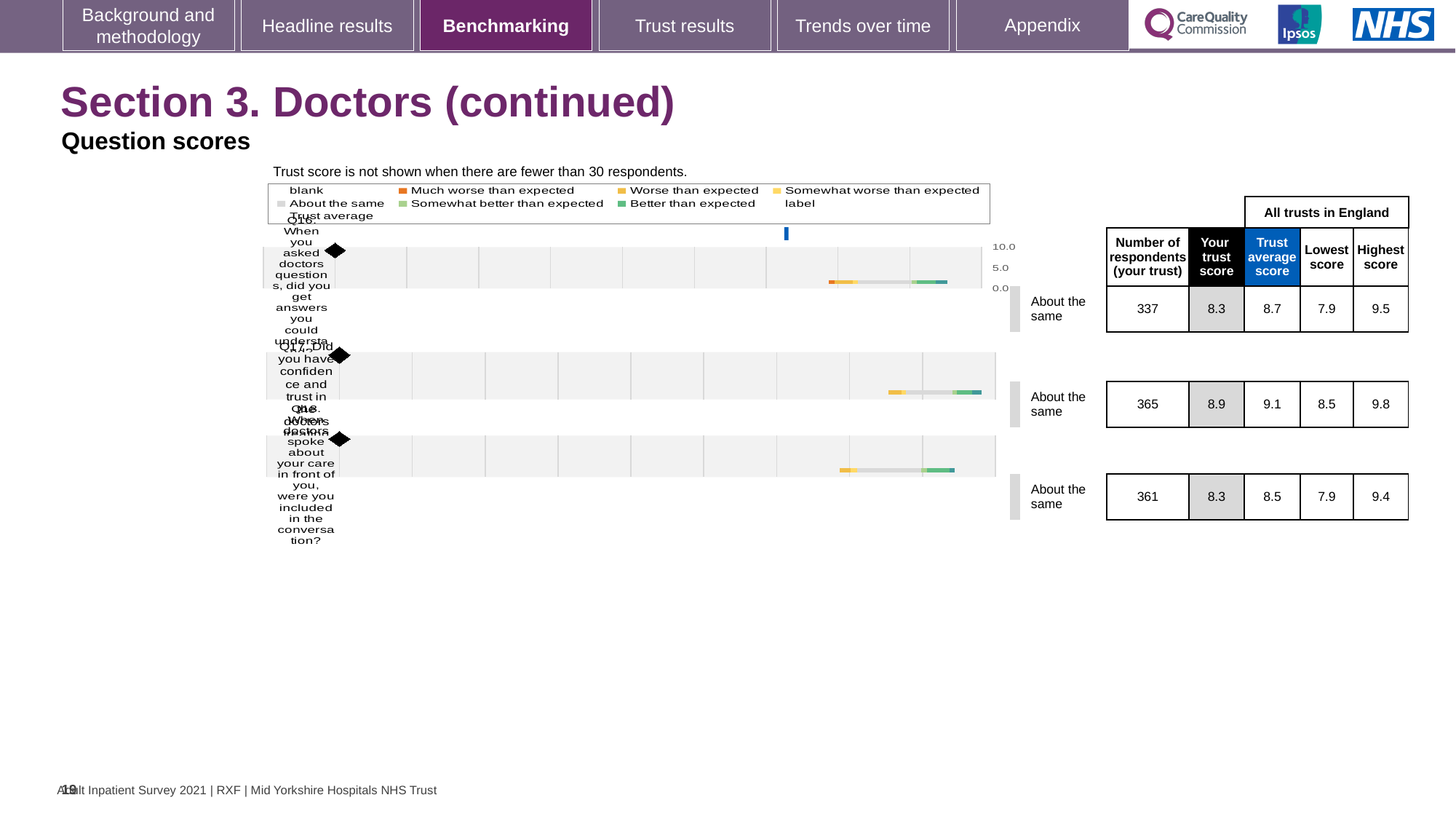
What is the highest score across all trusts in England for Q17? 9.8 Is your trust score for Q17 greater or less than 5.0? greater Which question has the highest 'Your trust score'? Q17 Which has the larger 'Your trust score', Q17 or Q18? Q17 What is the 'Your trust score' value for Q16 (When you asked doctors questions, did you get answers you could understand?)? 8.3 How many respondents from your trust answered Q18 (When doctors spoke about your care in front of you, were you included in the conversation?)? 361 What is the lowest score across all trusts in England for Q18? 7.9 What is the trust average score for Q17 (Did you have confidence and trust in the doctors treating you?)? 9.1 What kind of chart is used to show the question scores? Bar chart What benchmark category is shown for Q16? About the same How many questions are plotted in the chart? 3 What is the difference between the trust average score and your trust score for Q16? 0.4